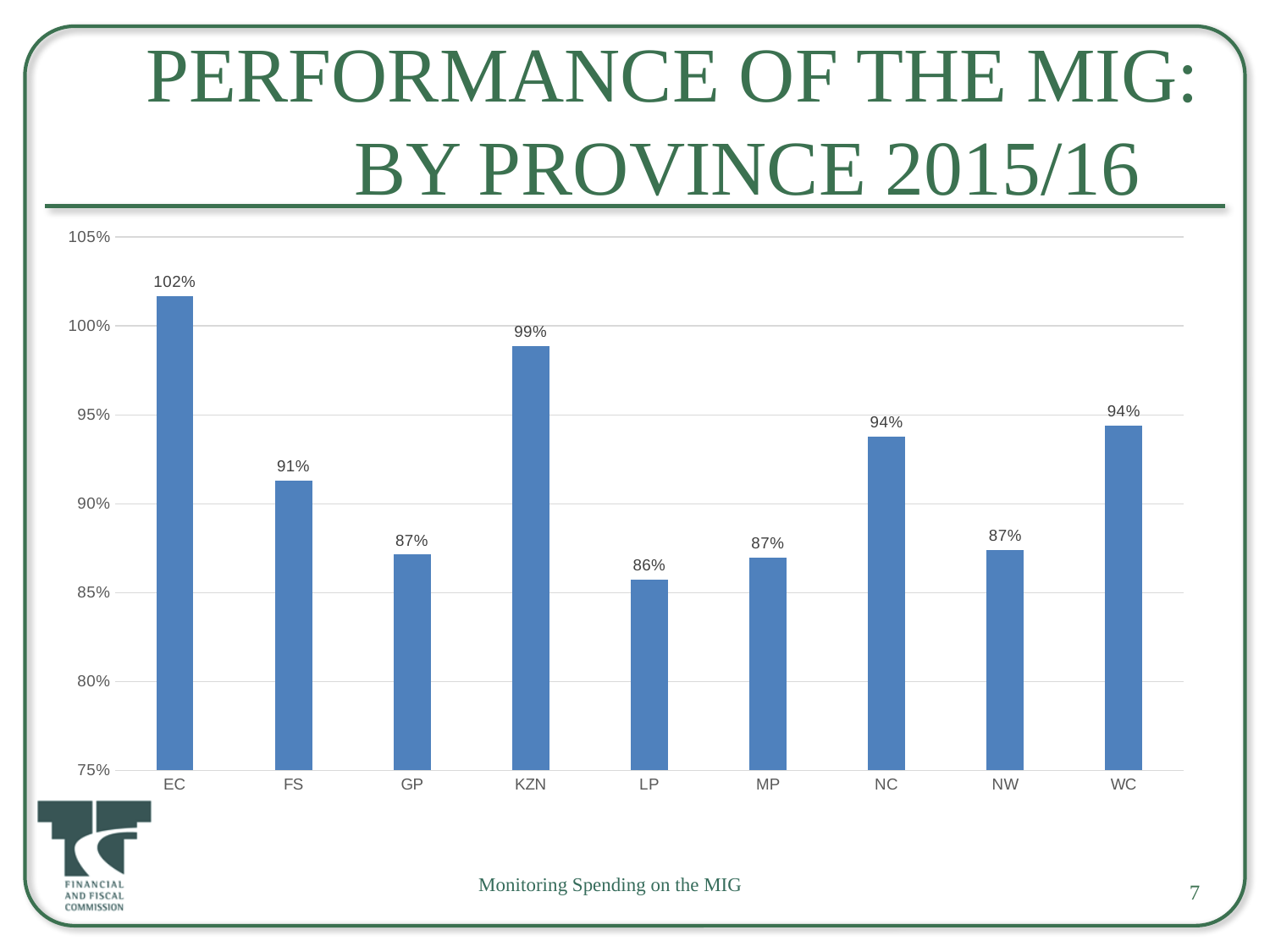
What is the value for EC? 102% Which province has the lowest value? LP What kind of chart is shown on the slide? bar chart Which province has the highest value? EC What is the value for KZN? 99% What is the value for LP? 86% What is the title of the slide? PERFORMANCE OF THE MIG: BY PROVINCE 2015/16 What is the value for FS? 91% How many provinces are shown on the chart? 9 Which is larger, the value for FS or the value for NC? NC What is the difference between the values for EC and LP? 16% Is the value for KZN greater or less than 100%? less